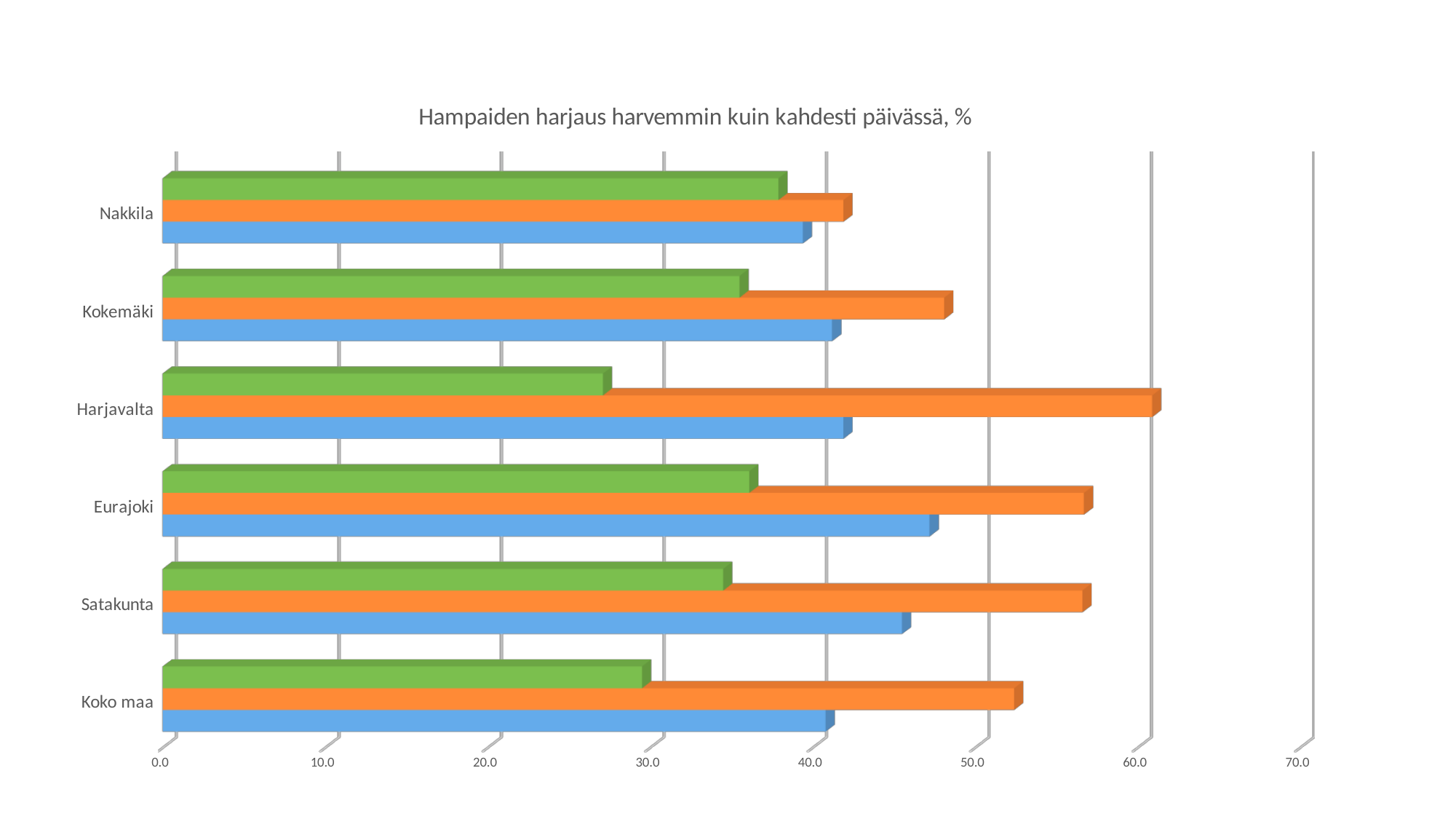
Which category has the longest orange bar? Harjavalta What is the title of the chart? Hampaiden harjaus harvemmin kuin kahdesti päivässä, % Is the orange bar for Eurajoki greater or less than 50.0? greater Which is larger, the orange bar for Harjavalta or the orange bar for Nakkila? Harjavalta Is the blue bar for Satakunta greater or less than 40.0? greater How many categories are shown on the vertical axis of the chart? 6 Which category has the shortest green bar? Harjavalta How many bars are plotted for each category in the chart? 3 What kind of chart is shown on the slide? bar chart Is the green bar for Harjavalta greater or less than 30.0? less Which is larger, the blue bar for Eurajoki or the blue bar for Nakkila? Eurajoki